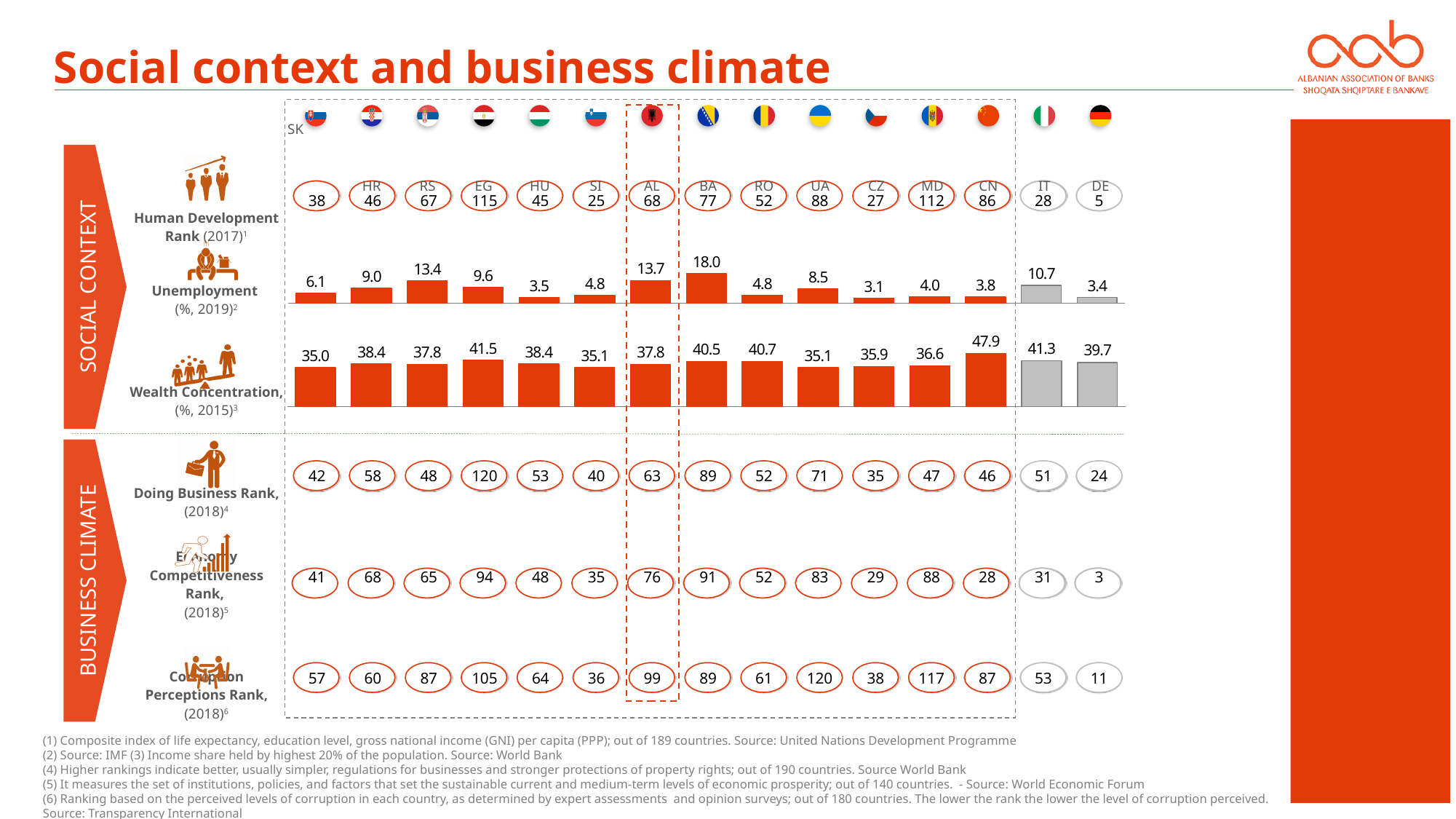
In the Wealth Concentration (%, 2015) chart, which country has the highest value? CN In the Wealth Concentration (%, 2015) chart, what is the difference between the values for EG and SK? 6.5 In the Unemployment (%, 2019) chart, which is larger, the value for RS or the value for IT? RS How many countries are shown in the Unemployment (%, 2019) chart? 15 In the Unemployment (%, 2019) chart, which country has the highest unemployment rate? BA In the Wealth Concentration (%, 2015) chart, what is the value for China (CN)? 47.9 In the Unemployment (%, 2019) chart, what is the difference between the values for BA and AL? 4.3 In the Wealth Concentration (%, 2015) chart, which is larger, the value for RO or the value for MD? RO In the Unemployment (%, 2019) chart, which country has the lowest unemployment rate? CZ What type of chart is used for Wealth Concentration (%, 2015)? Bar chart In the Wealth Concentration (%, 2015) chart, which country has the lowest value? SK In the Unemployment (%, 2019) chart, what is the value for Albania (AL)? 13.7